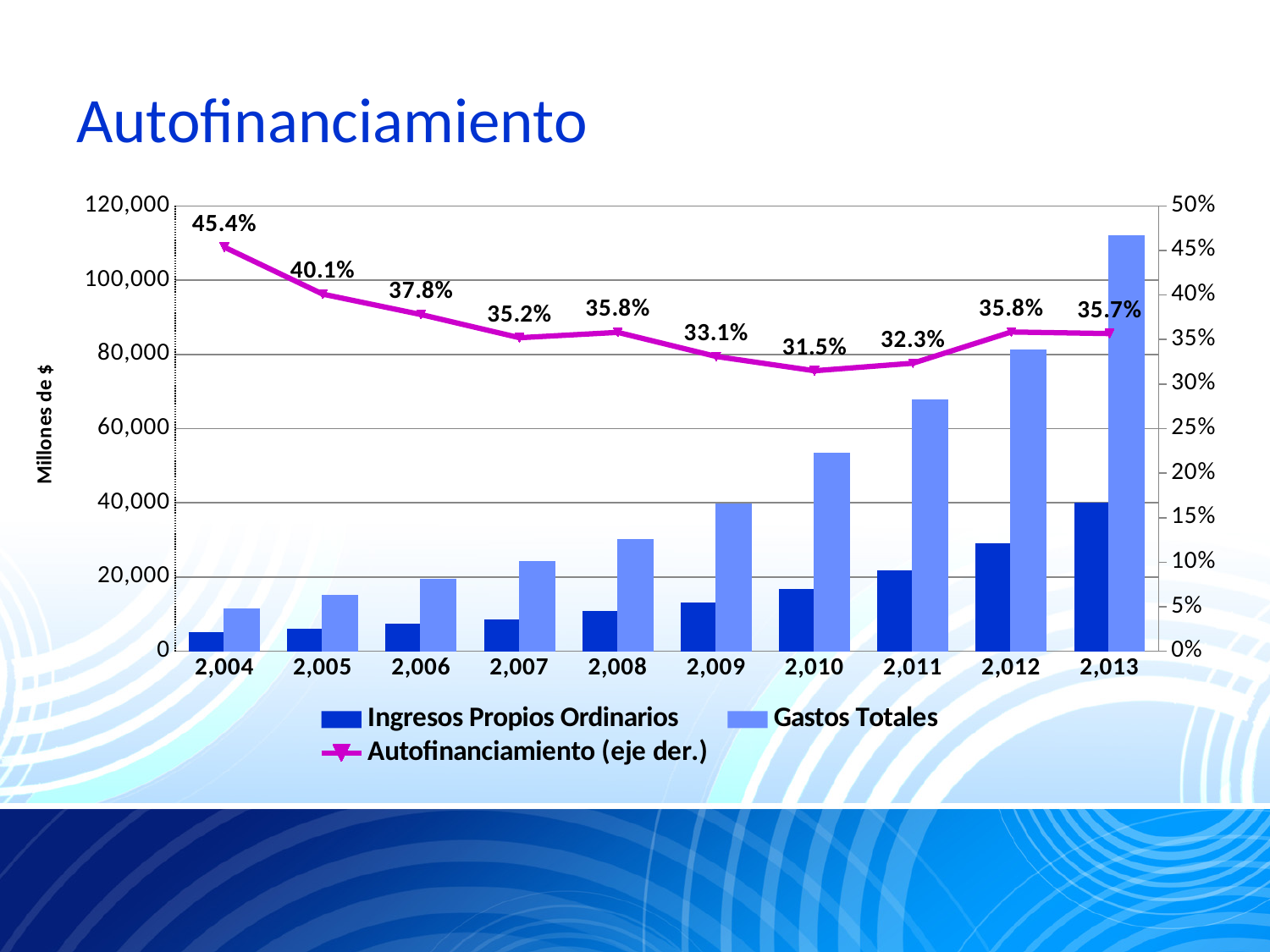
What is the difference in Autofinanciamiento between 2,004 and 2,005? 5.3 percentage points What is the Autofinanciamiento value for 2,004? 45.4% What is the Autofinanciamiento value for 2,010? 31.5% How many series does the legend list? 3 Which is larger in 2,013, Gastos Totales or Ingresos Propios Ordinarios? Gastos Totales In which year is the Autofinanciamiento percentage lowest? 2,010 Is the value for Gastos Totales in 2,013 greater or less than 100,000? greater In which year is the Autofinanciamiento percentage highest? 2,004 How many years are shown on the x axis? 10 Is the value for Gastos Totales in 2,004 greater or less than 20,000? less What is the Autofinanciamiento value for 2,008? 35.8% Do the Gastos Totales bars rise or fall from 2,004 to 2,013? rise